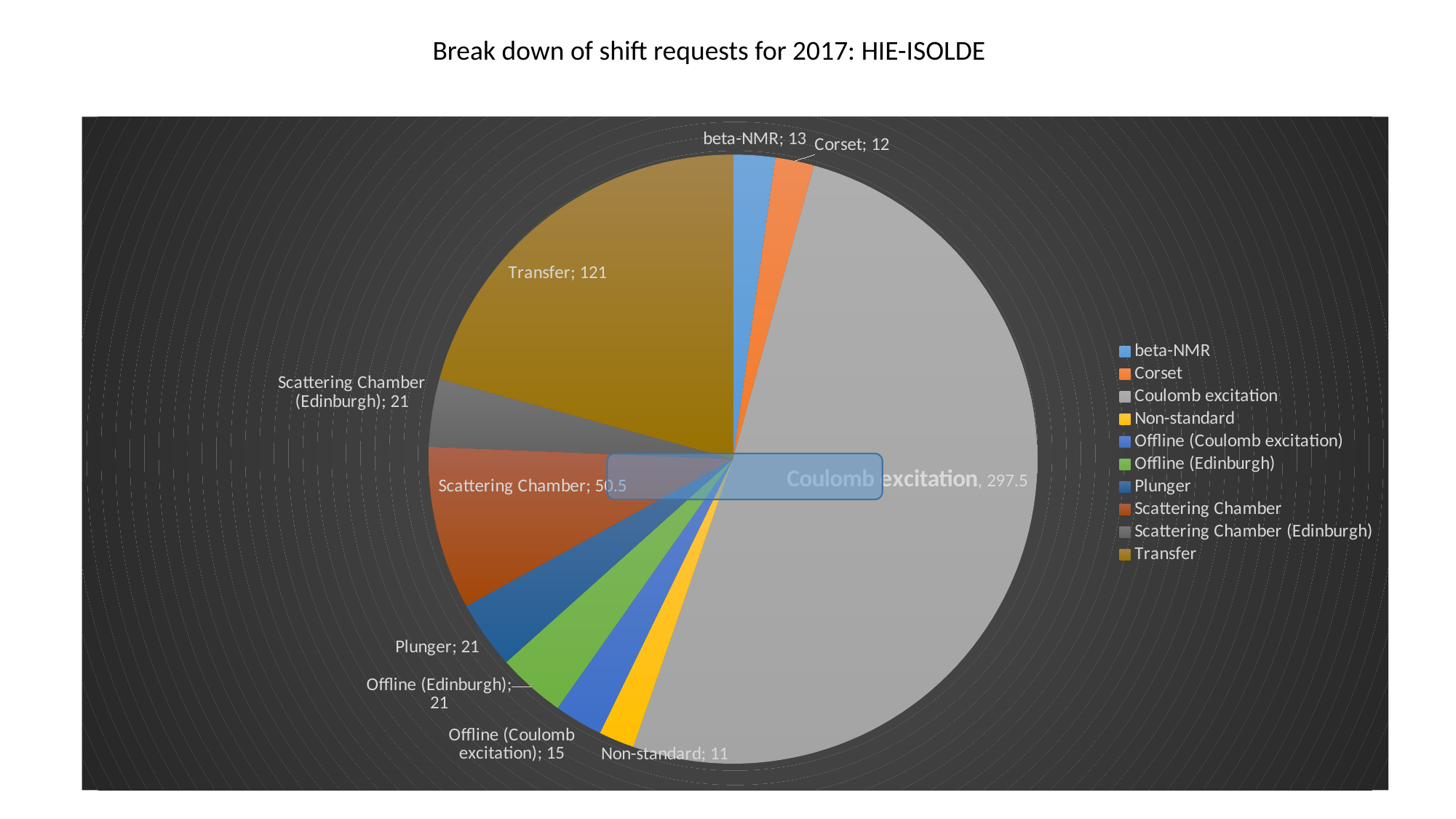
What is the value for Coulomb excitation? 297.5 What is the difference between the values for Transfer and Scattering Chamber? 70.5 Which category has the largest slice of the pie? Coulomb excitation How many shift requests are shown for Transfer? 121 What is the value for Scattering Chamber? 50.5 What is the title of the chart? Break down of shift requests for 2017: HIE-ISOLDE How many entries does the legend list? 10 Which is larger, the value for beta-NMR or the value for Corset? beta-NMR What is the value for Offline (Coulomb excitation)? 15 Which category has the smallest value? Non-standard How many categories are shown in the pie chart? 10 What type of chart is shown on the slide? Pie chart